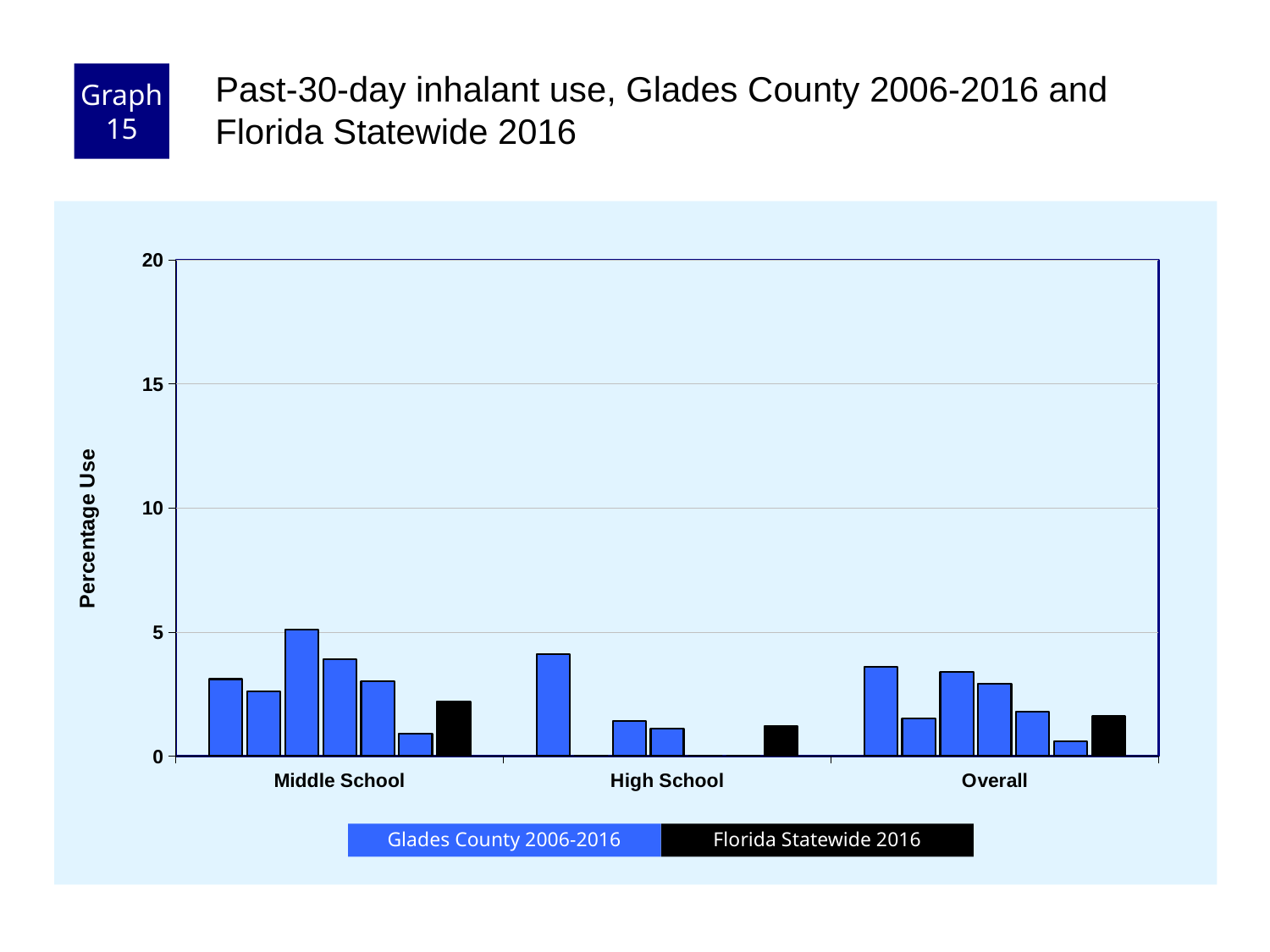
Is the Florida Statewide 2016 value for Overall greater or less than 5? less What is the label on the vertical axis? Percentage Use Which category has the lowest Florida Statewide 2016 value? High School How many series does the legend list? 2 How many categories are shown along the x axis? 3 Which category contains the tallest bar on the chart? Middle School Is the Florida Statewide 2016 value for Middle School greater or less than 5? less What kind of chart is shown on the slide? bar chart Which category has the highest Florida Statewide 2016 value? Middle School Which colour represents Florida Statewide 2016 in the legend? black Is the Florida Statewide 2016 value larger for Middle School or for High School? Middle School Is the Florida Statewide 2016 value for High School greater or less than 5? less